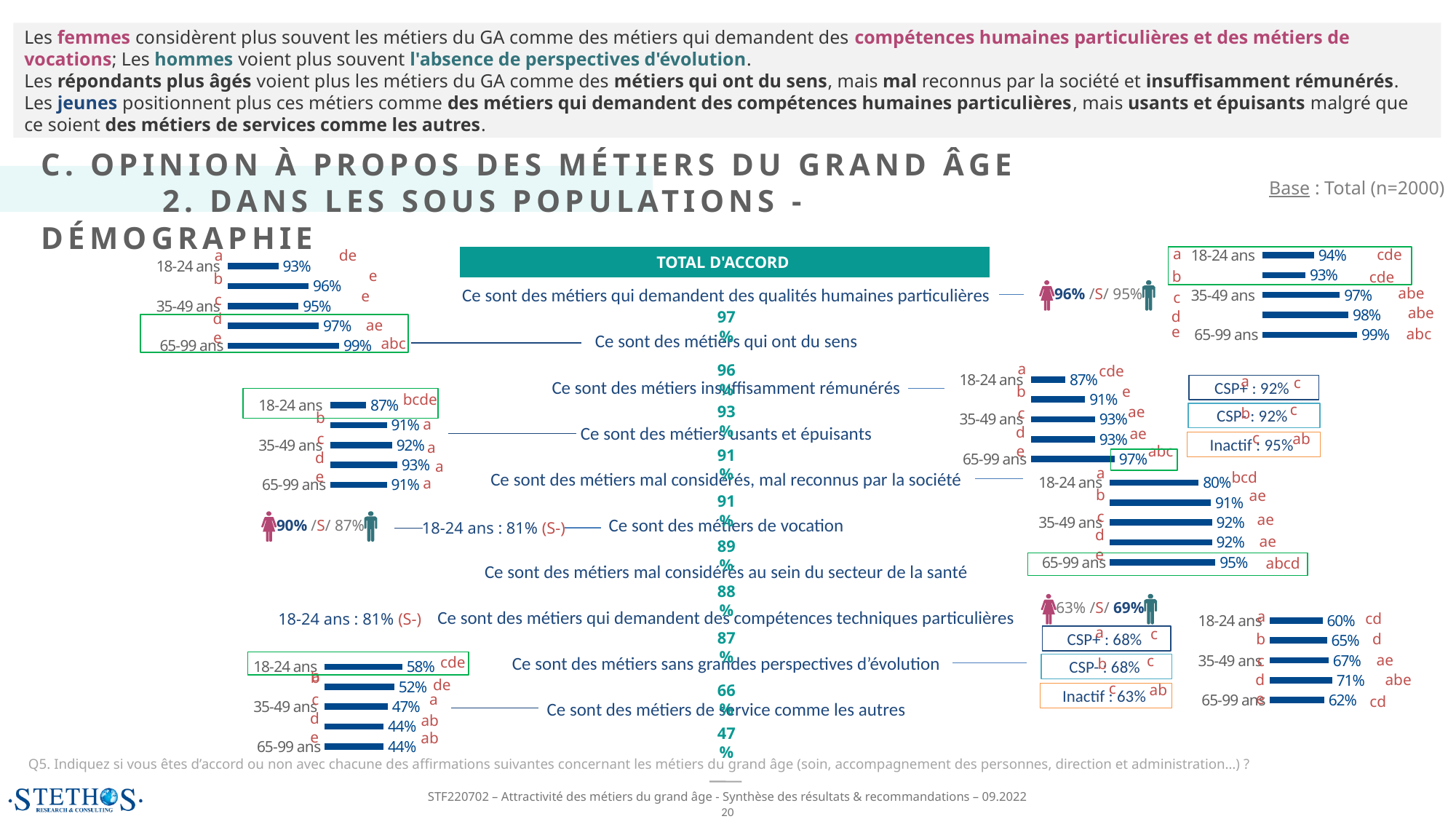
In the bottom-left age-group bar chart (linked to 'Ce sont des métiers de service comme les autres'), what is the difference between the values for 18-24 ans and 65-99 ans? 14% In the middle-right age-group bar chart (linked to 'Ce sont des métiers insuffisamment rémunérés'), what is the value for 65-99 ans? 97% In the top-left age-group bar chart (linked to 'Ce sont des métiers qui ont du sens'), what is the value for 18-24 ans? 93% In the age-group bar chart linked to 'Ce sont des métiers mal considérés, mal reconnus par la société', what is the value for 18-24 ans? 80% How many bars does each age-group bar chart on the slide contain? 5 In the top-right age-group bar chart (linked to 'Ce sont des métiers qui demandent des qualités humaines particulières'), what is the value for 35-49 ans? 97% In the bottom-right age-group bar chart (linked to 'Ce sont des métiers sans grandes perspectives d'évolution'), what is the value for 18-24 ans? 60% What kind of chart is used to show the age-group results on the slide? Bar chart In the middle-left age-group bar chart (linked to 'Ce sont des métiers usants et épuisants'), what is the value for 35-49 ans? 92% In the bottom-right age-group bar chart (linked to 'Ce sont des métiers sans grandes perspectives d'évolution'), which is larger: the value for 35-49 ans or for 65-99 ans? 35-49 ans In the top-left age-group bar chart (linked to 'Ce sont des métiers qui ont du sens'), what is the value for 65-99 ans? 99% In the bottom-left age-group bar chart (linked to 'Ce sont des métiers de service comme les autres'), which labelled age group has the highest value? 18-24 ans